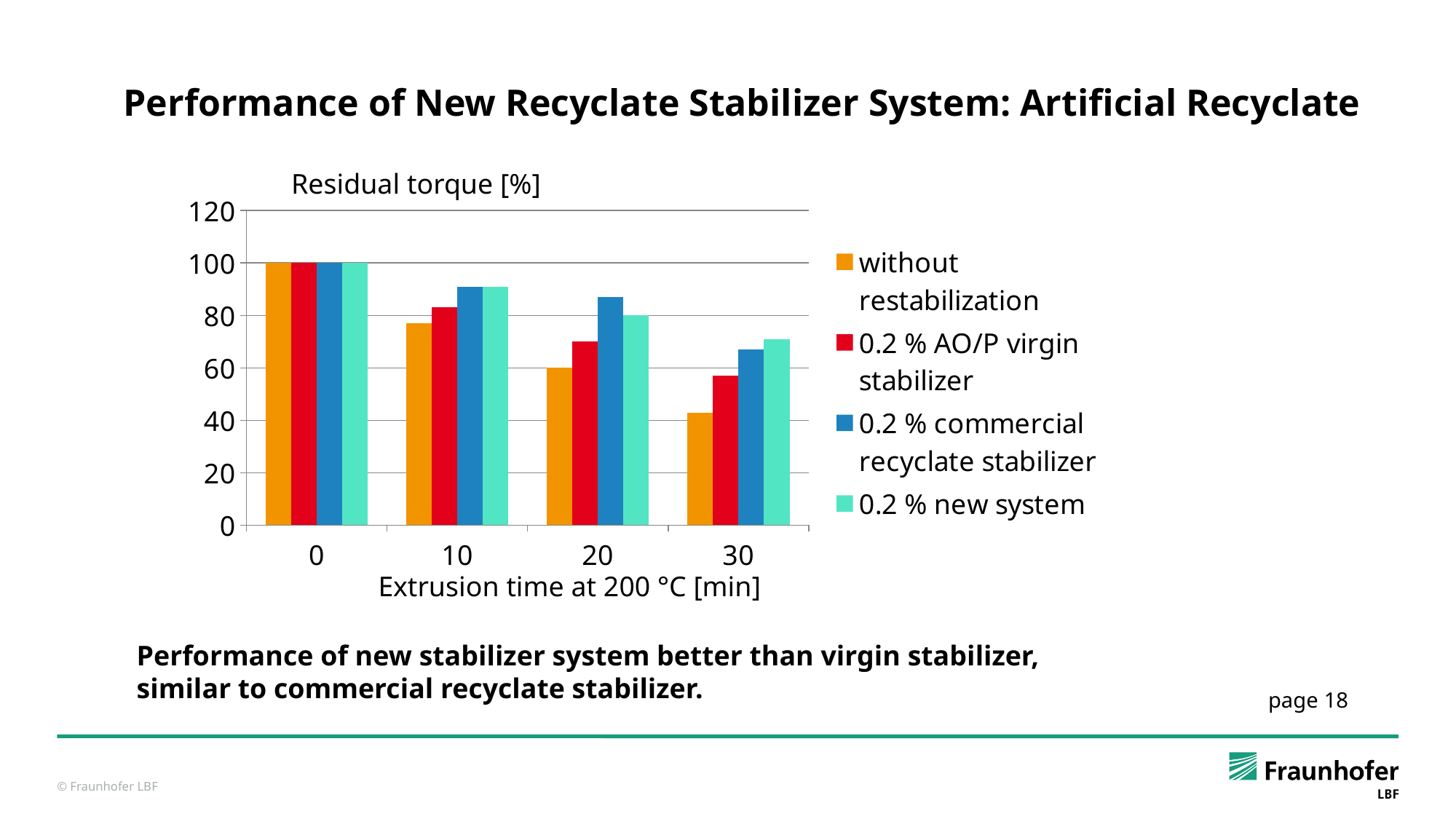
Is the value for 'without restabilization' at 30 min greater or less than 60? less What is the residual torque for 'without restabilization' at an extrusion time of 0 min? 100 Is the value for '0.2 % new system' at 10 min greater or less than 80? greater At 30 min, which is larger: '0.2 % new system' or '0.2 % AO/P virgin stabilizer'? 0.2 % new system How many extrusion time categories are shown on the x axis? 4 At 20 min, which series has the highest residual torque? 0.2 % commercial recyclate stabilizer What kind of chart is shown on the slide? bar chart At 30 min, which series has the lowest residual torque? without restabilization Is the value for '0.2 % commercial recyclate stabilizer' at 20 min greater or less than 80? greater What is the title of the y axis? Residual torque [%] How many series does the legend list? 4 Do the values for 'without restabilization' rise or fall as extrusion time increases? fall